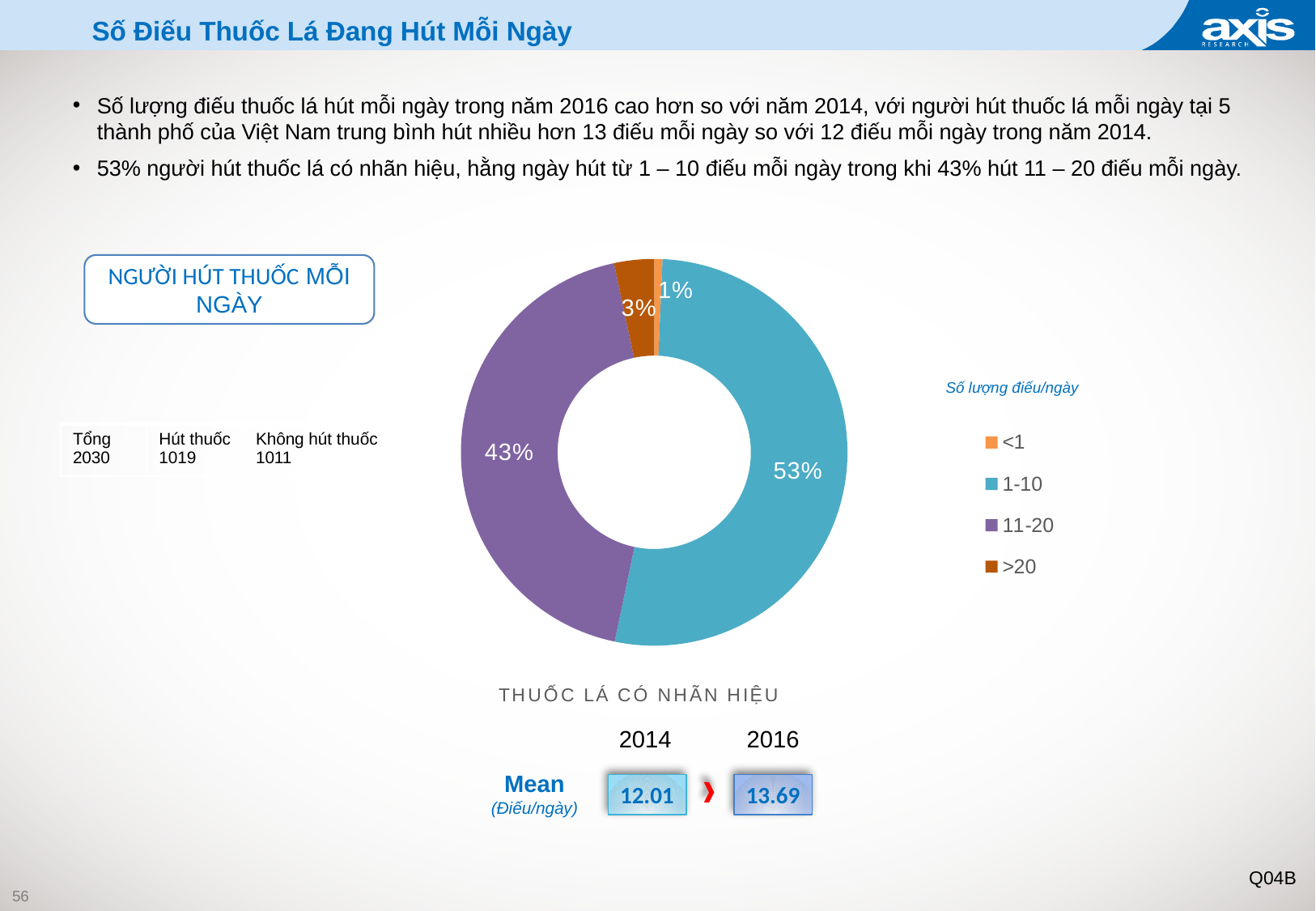
How many categories are shown in the donut chart? 4 What kind of chart is shown on the slide? Donut (pie) chart What share of the donut chart does the >20 category represent? 3% What colour is the 11-20 slice in the donut chart? Purple What share of the donut chart does the 11-20 category represent? 43% What share of the donut chart does the 1-10 category represent? 53% What share of the donut chart does the <1 category represent? 1% Which category has the smallest share in the donut chart? <1 Which category has the largest share in the donut chart? 1-10 What is the title shown below the donut chart? THUỐC LÁ CÓ NHÃN HIỆU Which share is larger, 11-20 or >20? 11-20 What is the difference in percentage points between the 1-10 and 11-20 shares? 10